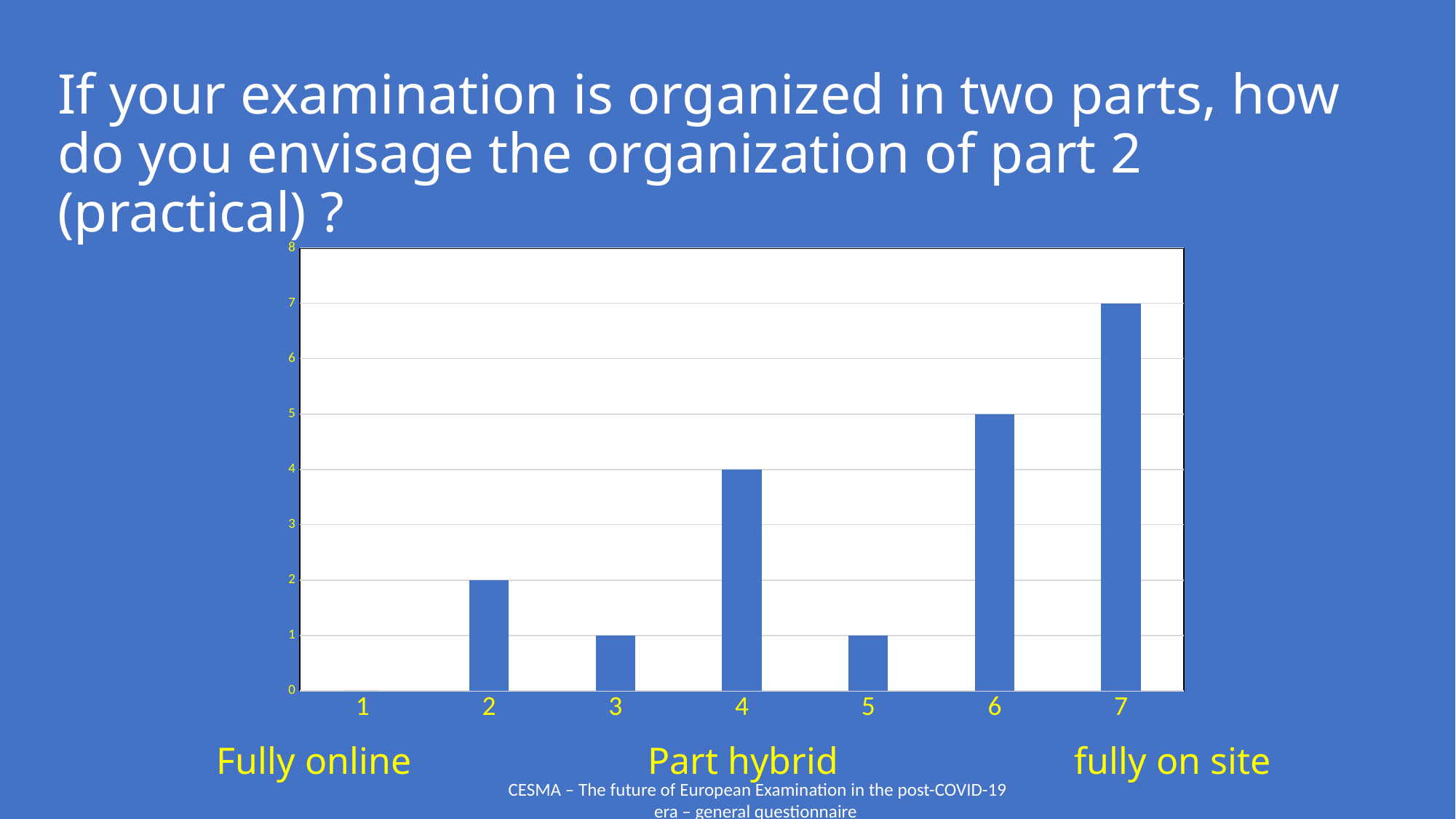
What is the value for category 4? 4 How many categories are shown on the x axis of the chart? 7 What kind of chart is shown on the slide? bar chart What is the value for category 7? 7 Is the value for category 6 greater or less than 4? greater What is the value for category 3? 1 What is the value for category 2? 2 Which category has the highest bar? 7 What label is shown under the right end of the x axis? fully on site What is the difference between the values for category 7 and category 6? 2 Which is larger, the value for category 4 or the value for category 2? category 4 What is the value for category 6? 5